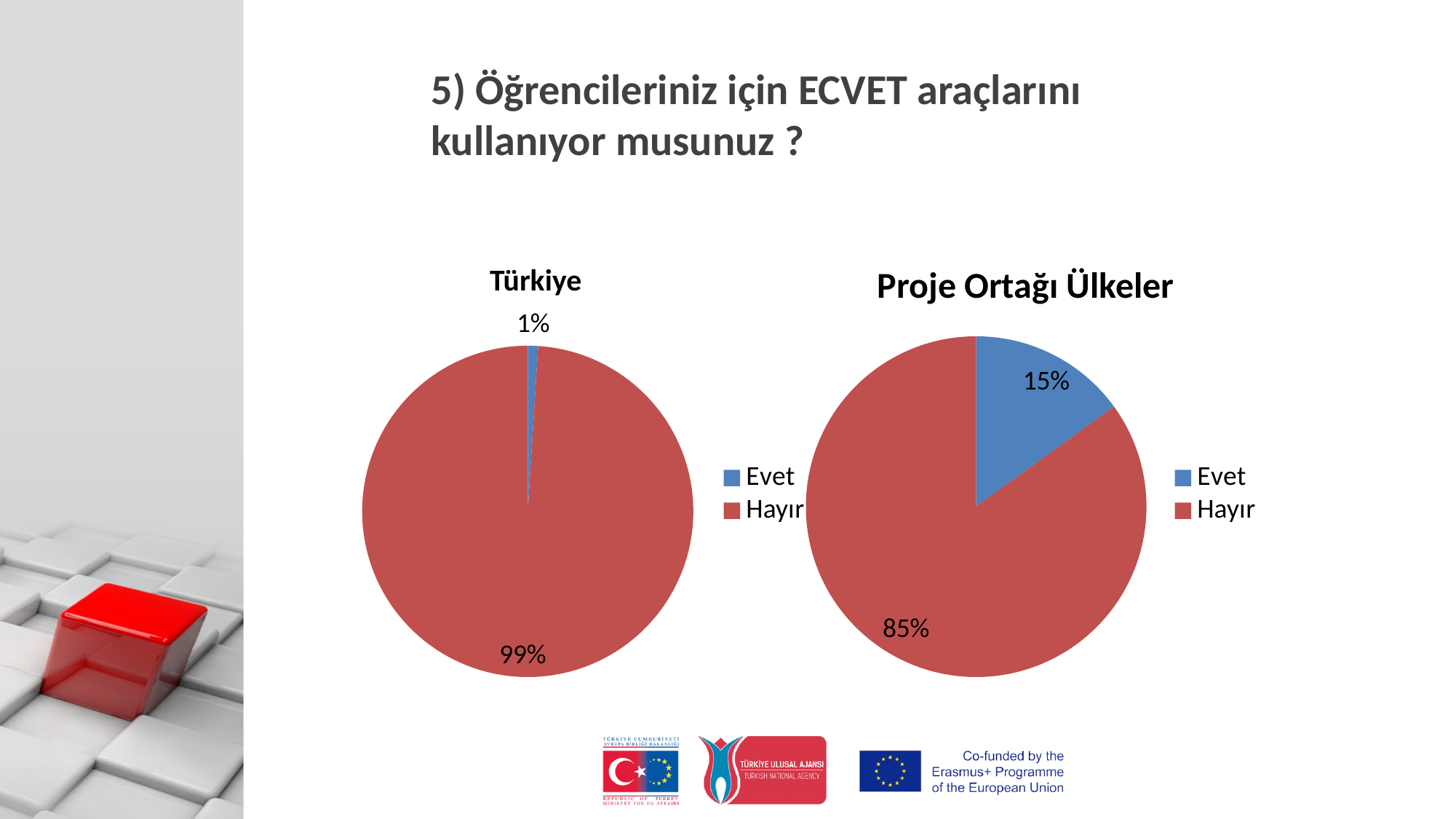
In the "Türkiye" chart, what share of the pie is "Hayır"? 99% What type of chart is the "Türkiye" chart? Pie chart In the "Proje Ortağı Ülkeler" chart, which category has the smallest slice? Evet In the "Türkiye" chart, what share of the pie is "Evet"? 1% In the "Türkiye" chart, what colour is the "Hayır" slice? Red In the "Proje Ortağı Ülkeler" chart, what share of the pie is "Hayır"? 85% How many categories does the "Proje Ortağı Ülkeler" chart show? 2 In the "Türkiye" chart, which category has the largest slice? Hayır What is the title of the chart on the right? Proje Ortağı Ülkeler In the "Proje Ortağı Ülkeler" chart, what is the difference between the "Hayır" and "Evet" shares? 70% Which chart has the larger "Evet" share, "Türkiye" or "Proje Ortağı Ülkeler"? Proje Ortağı Ülkeler